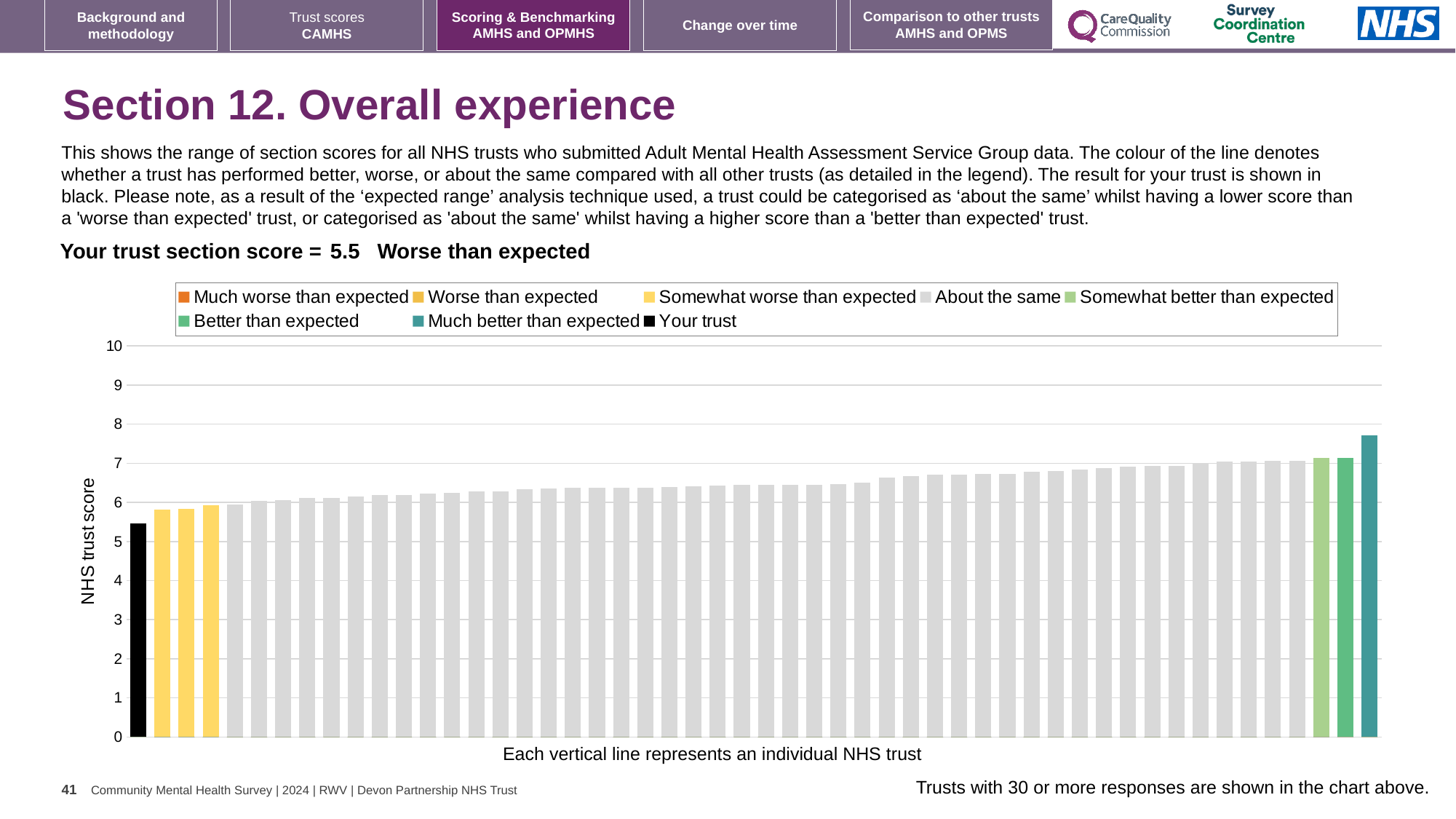
Which legend category does the lowest bar in the chart belong to? Your trust Do the bar values rise or fall from left to right along the x axis? rise How many bars are coloured as 'Somewhat worse than expected'? 3 Which is larger: the value for your trust or the value of the teal 'Much better than expected' bar? Much better than expected Which legend category does the highest bar in the chart belong to? Much better than expected What is the section score for your trust? 5.5 What colour is the bar representing your trust? black What kind of chart is shown on the slide? bar chart What is the label on the vertical axis of the chart? NHS trust score Is the value of the tallest bar (Much better than expected) greater or less than 7? greater How many entries does the chart legend list? 8 Is the value for your trust (the black bar) greater or less than 6? less